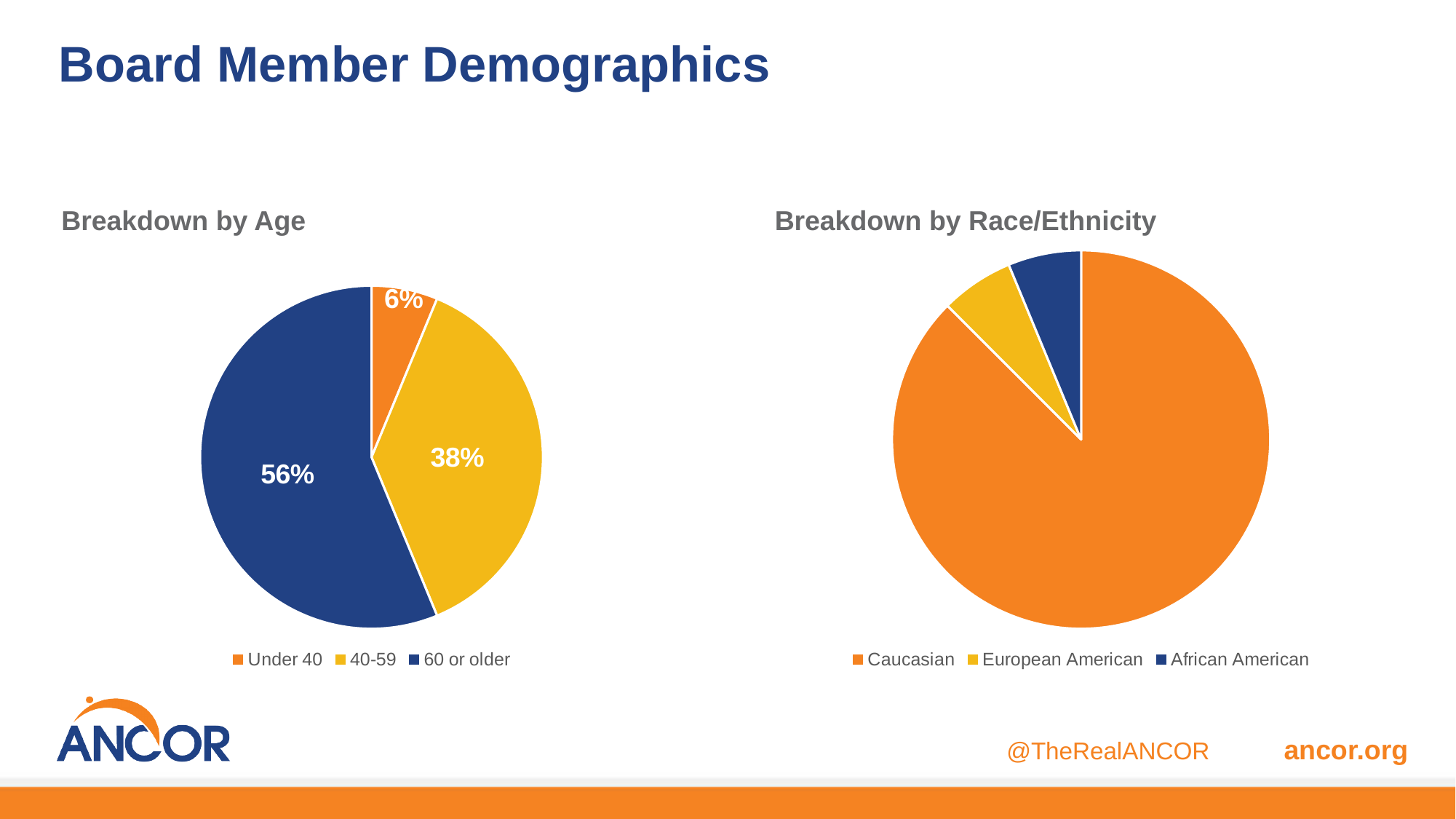
In the 'Breakdown by Age' chart, what is the difference in percentage points between the 60 or older and 40-59 groups? 18 In the 'Breakdown by Race/Ethnicity' chart, which group has the largest share? Caucasian In the 'Breakdown by Age' chart, what share of board members are under 40? 6% In the 'Breakdown by Age' chart, which age group has the largest share? 60 or older What type of chart is the 'Breakdown by Age' chart? Pie chart In the 'Breakdown by Race/Ethnicity' chart, what colour is the European American slice? Yellow In the 'Breakdown by Age' chart, what share of board members are 60 or older? 56% In the 'Breakdown by Race/Ethnicity' chart, which is larger: the Caucasian slice or the African American slice? Caucasian How many categories does the 'Breakdown by Race/Ethnicity' chart show? 3 In the 'Breakdown by Age' chart, what share of board members are aged 40-59? 38% In the 'Breakdown by Age' chart, which is larger: the share for 40-59 or the share for Under 40? 40-59 In the 'Breakdown by Age' chart, which age group has the smallest share? Under 40